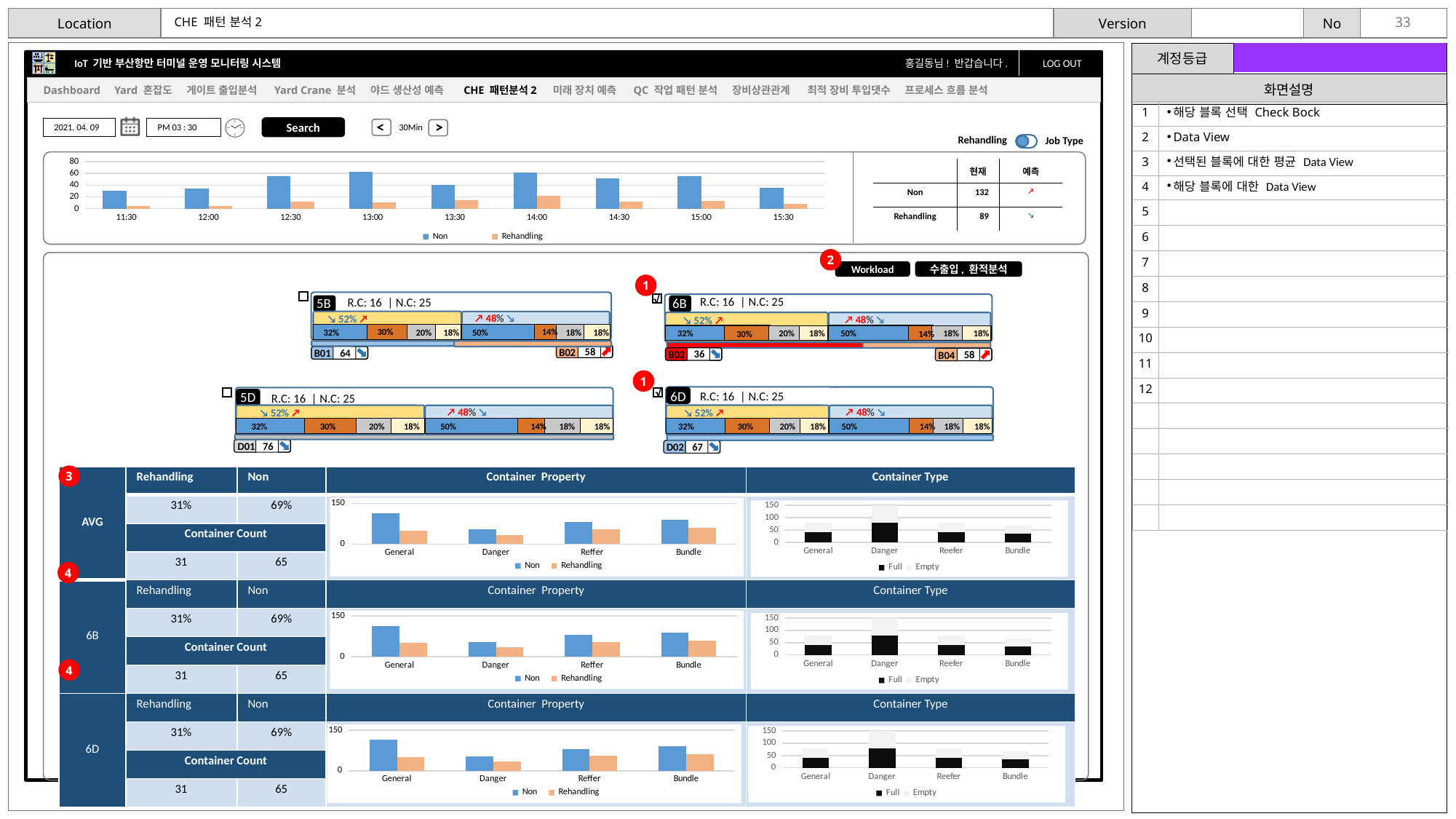
What kind of chart is the chart at the top of the slide with the time categories 11:30 to 15:30? bar chart In the AVG row's Container Property chart, how many categories are shown on the x axis? 4 In the AVG row's Container Type chart, which category has the tallest stacked bar? Danger In the top chart with time categories, how many time categories are shown on the x axis? 9 In the top chart with time categories, how many series does the legend list? 2 In the top chart with time categories, which is larger at 12:30, Non or Rehandling? Non In the AVG row's Container Property chart, which category has the lowest Rehandling value? Danger In the top chart with time categories, at which time is the Rehandling value highest? 14:00 In the AVG row's Container Type chart, what are the two legend entries? Full, Empty In the top chart with time categories, is the Non value at 13:00 greater or less than 40? greater In the AVG row's Container Property chart, which category has the highest Non value? General In the top chart with time categories, is the Rehandling value at 14:00 greater or less than 40? less